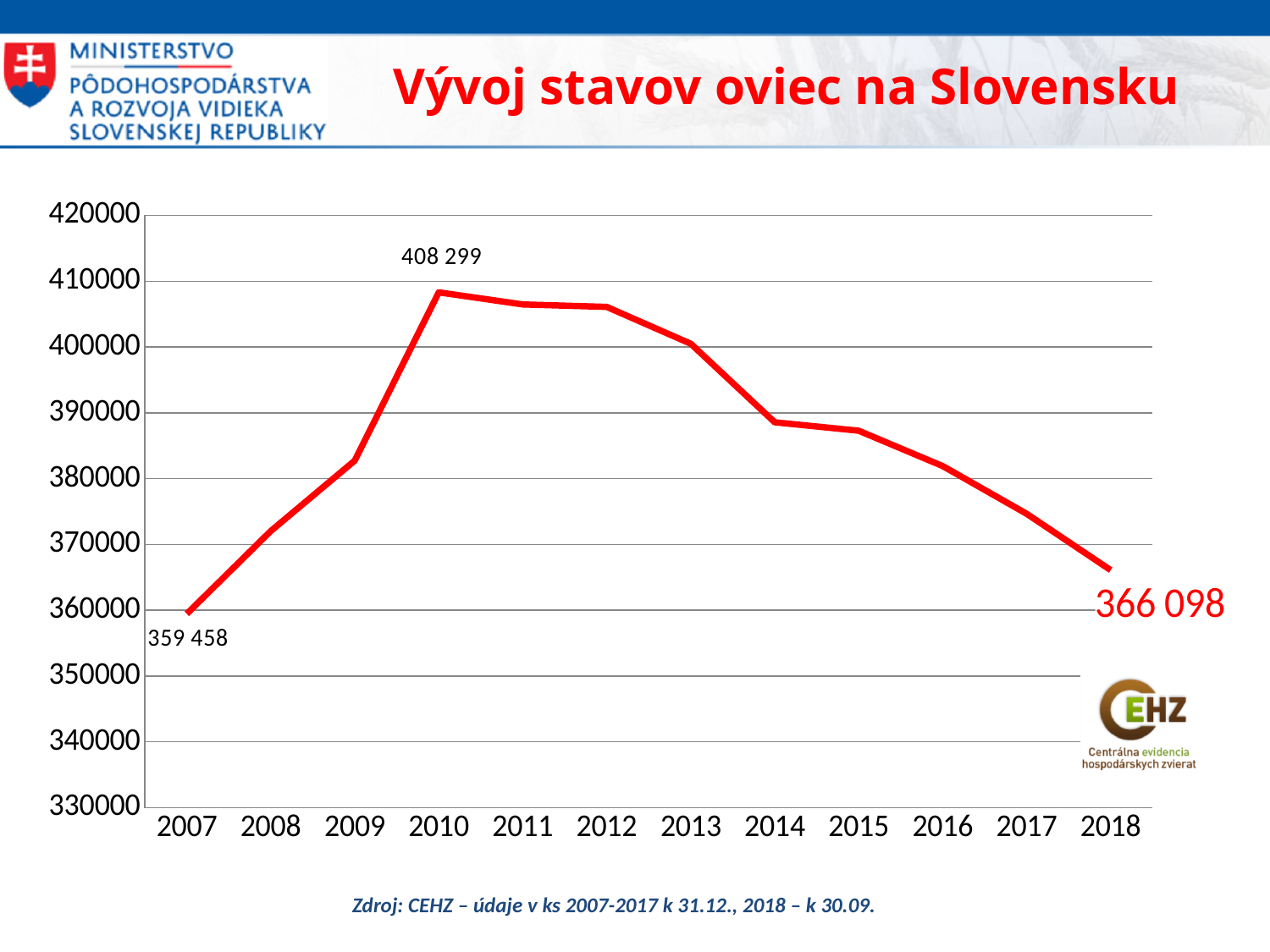
What is the value plotted for 2007? 359 458 What is the difference between the values for 2010 and 2018? 42 201 Which is larger, the value for 2007 or the value for 2018? 2018 What is the value plotted for 2010? 408 299 Which year has the lowest value on the chart? 2007 What is the difference between the values for 2010 and 2007? 48 841 What is the value plotted for 2018? 366 098 Which year has the highest value on the chart? 2010 How many years are plotted on the x axis? 12 Is the value for 2011 greater or less than 400000? greater Is the value for 2014 greater or less than 390000? less What kind of chart is shown on the slide? line chart